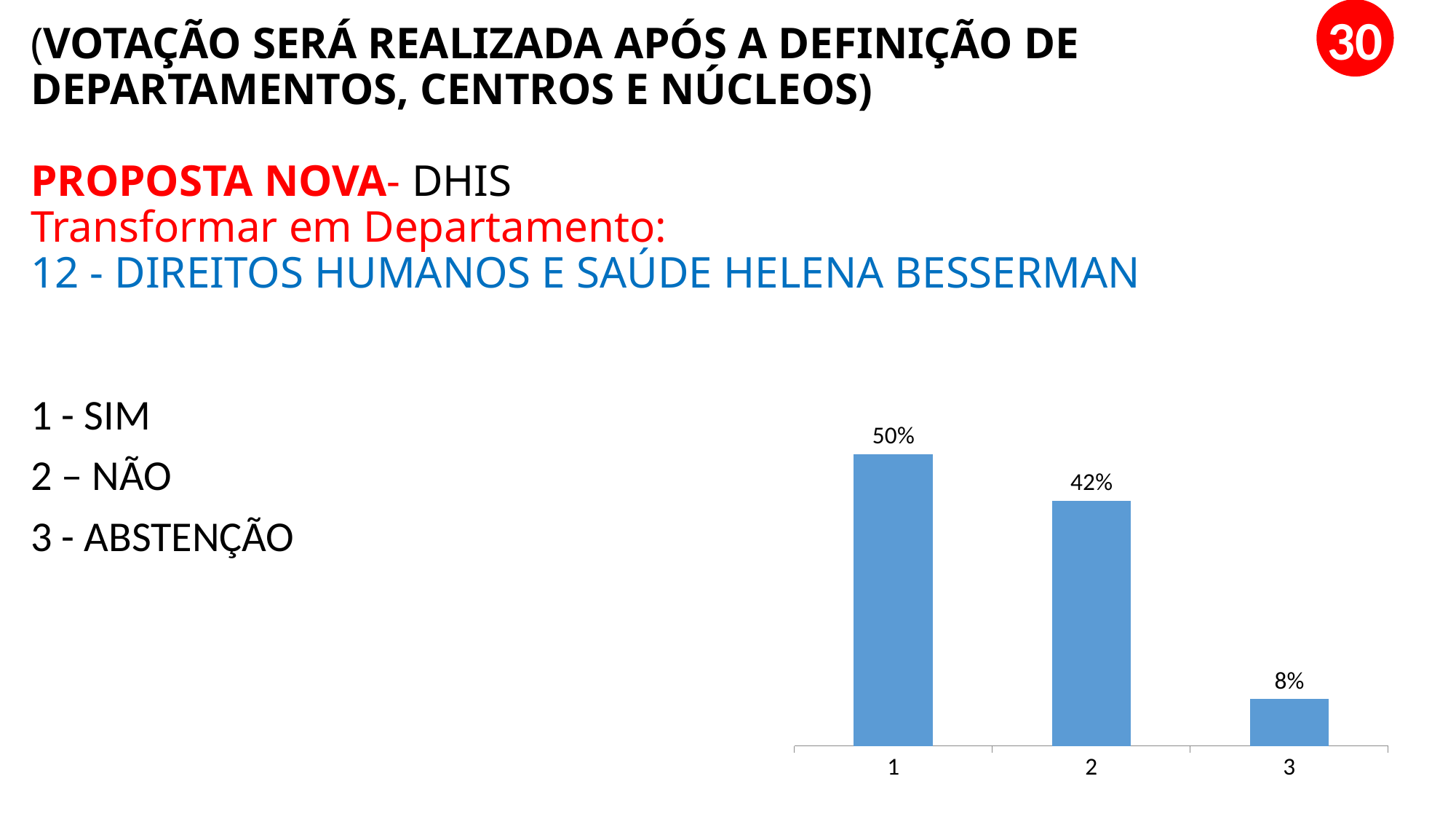
What is the difference between the values for category 1 and category 2? 8% Which category has the highest value in the bar chart? 1 What colour are the bars in the chart? blue Which is larger, the value for category 2 or the value for category 3? 2 What is the value shown for category 2 in the bar chart? 42% What is the difference between the values for category 2 and category 3? 34% What is the value shown for category 3 in the bar chart? 8% How many bars are plotted in the chart? 3 Do the values rise or fall from category 1 to category 3? fall Which category has the lowest value in the bar chart? 3 What is the value shown for category 1 in the bar chart? 50% What kind of chart is shown on the slide? bar chart